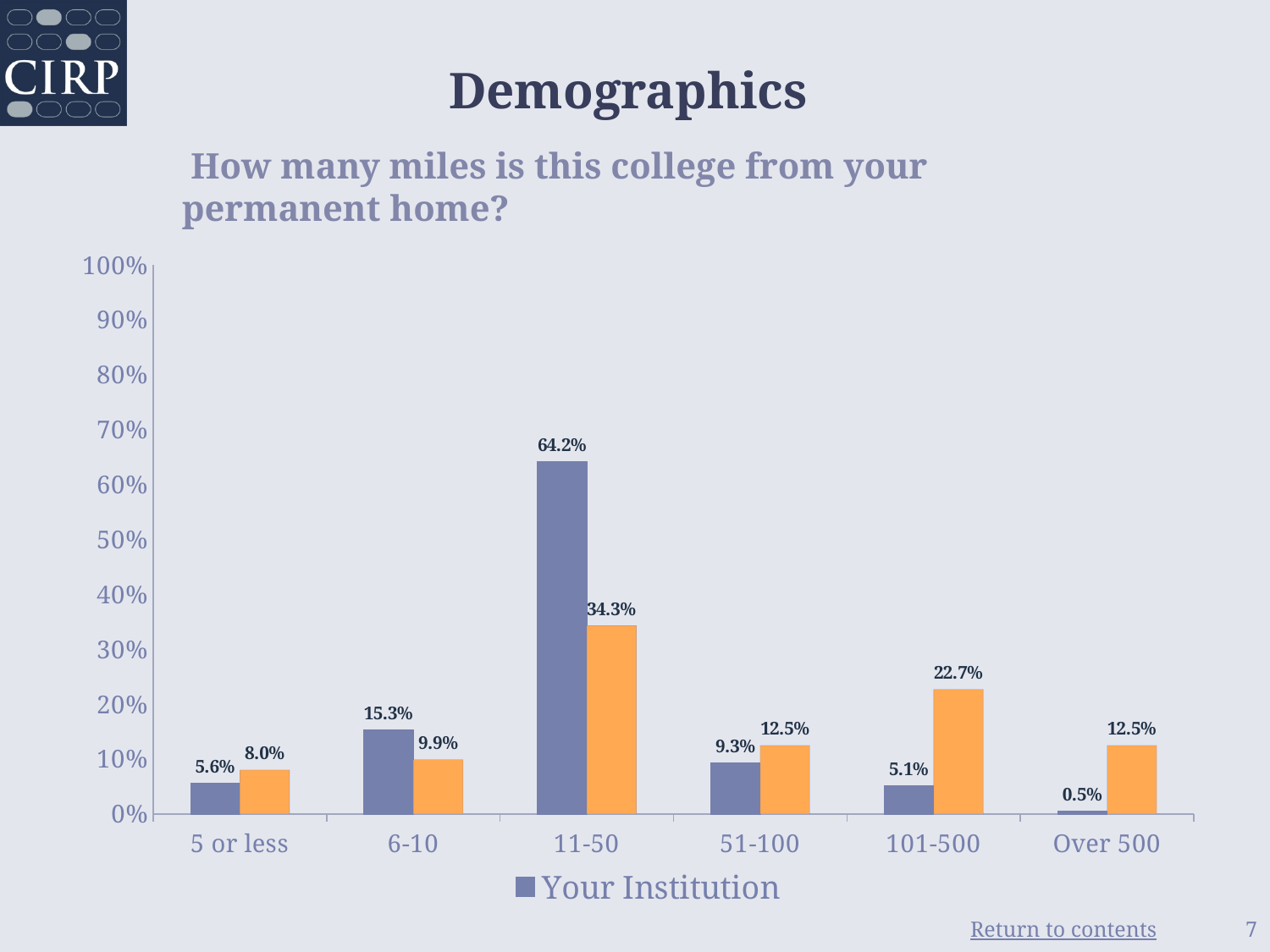
For Your Institution, which is larger: the value for 5 or less or the value for 101-500? 5 or less Which category has the highest value for Your Institution? 11-50 In the 11-50 category, is the Your Institution bar larger or smaller than the orange bar next to it? larger How many series does the legend list? 1 Which category has the lowest value for Your Institution? Over 500 What is the difference between the Your Institution values for 11-50 and 6-10? 48.9 percentage points What is the value for Your Institution in the 51-100 category? 9.3% What is the value for Your Institution in the 6-10 category? 15.3% What is the value for Your Institution in the 11-50 category? 64.2% What kind of chart is shown on the slide? bar chart Is the Your Institution value for 11-50 greater or less than 60%? greater How many distance categories are shown on the x axis? 6